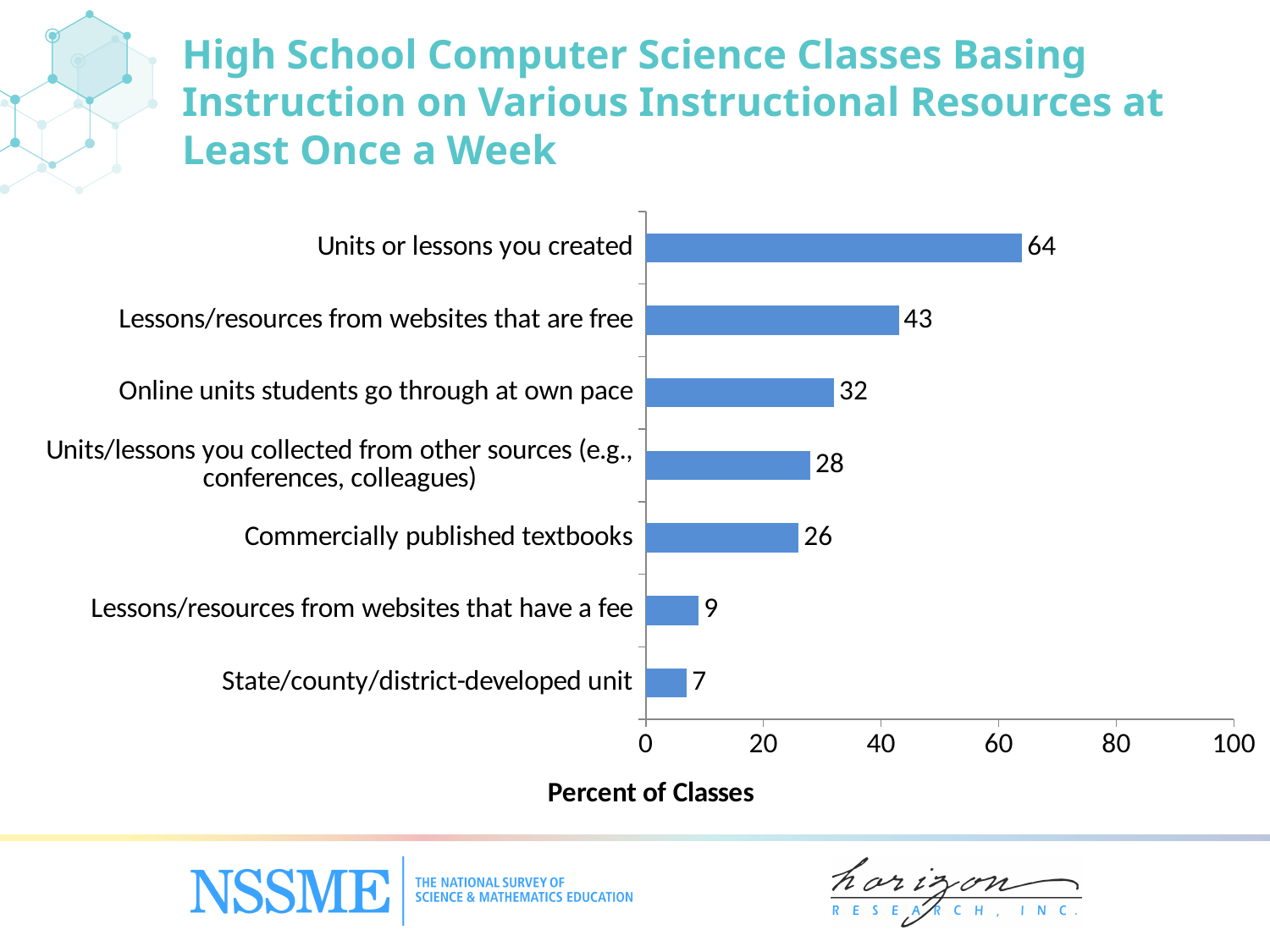
What is the difference between the values for 'Units or lessons you created' and 'Lessons/resources from websites that are free'? 21 Is the value for 'Units/lessons you collected from other sources (e.g., conferences, colleagues)' greater or less than 40? less What is the difference between the values for 'Lessons/resources from websites that have a fee' and 'State/county/district-developed unit'? 2 What kind of chart is shown on the slide? Bar chart What is the value for 'Lessons/resources from websites that are free'? 43 How many instructional resource categories are shown in the chart? 7 What is the value for 'Commercially published textbooks'? 26 Which instructional resource has the lowest percent of classes? State/county/district-developed unit What is the label of the horizontal axis? Percent of Classes What percent of classes base instruction on units or lessons the teacher created at least once a week? 64 Which is larger: the value for 'Online units students go through at own pace' or 'Commercially published textbooks'? Online units students go through at own pace Which instructional resource has the highest percent of classes? Units or lessons you created